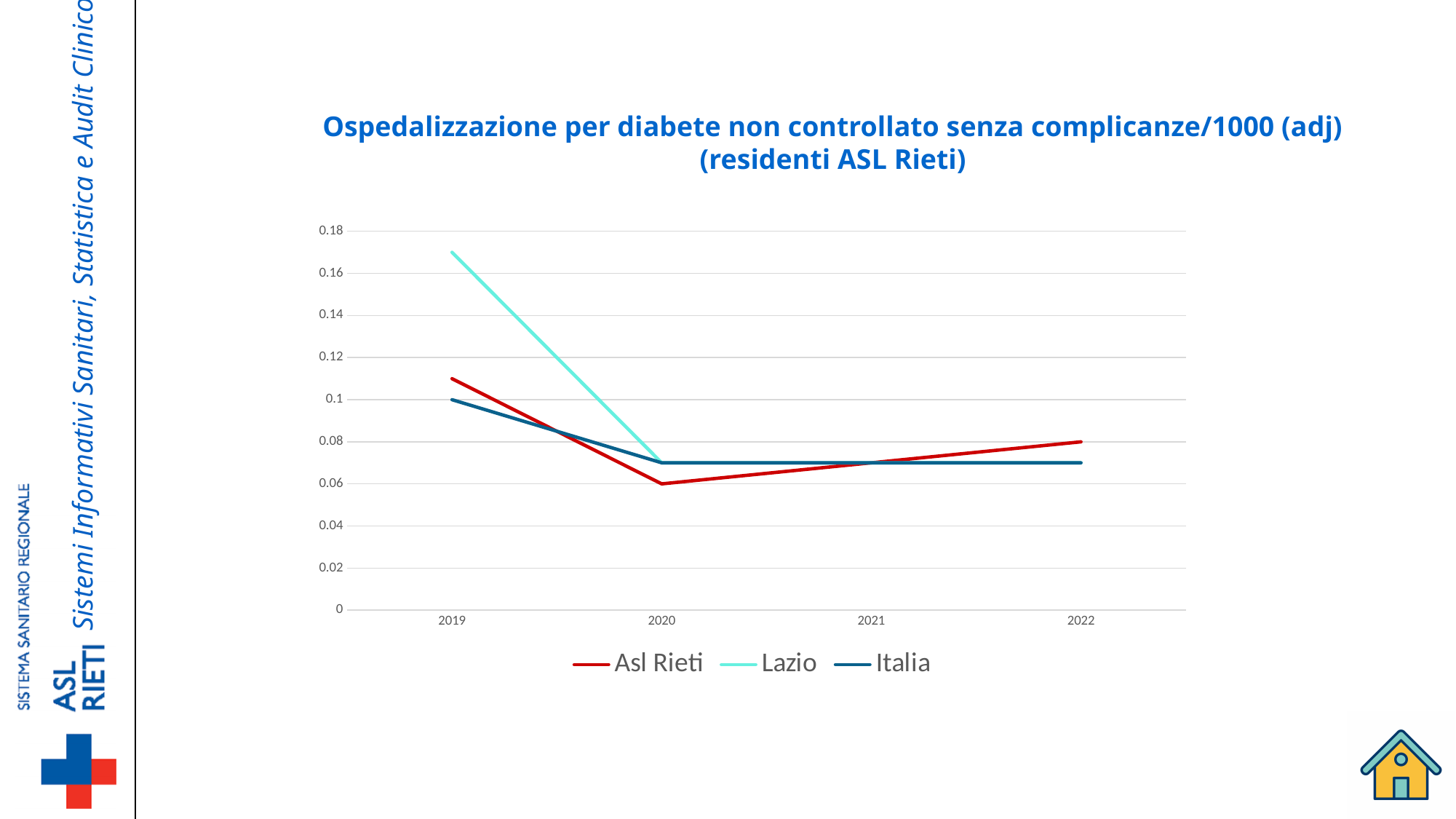
Which series has the lowest value in 2020? Asl Rieti What is the value for Asl Rieti in 2022? 0.08 What is the value for Italia in 2019? 0.1 By how much did the Asl Rieti value increase from 2020 to 2022? 0.02 What kind of chart is shown on the slide? line chart Which series has the highest value in 2019? Lazio In 2022, which is larger: Asl Rieti or Italia? Asl Rieti Is the value for Lazio in 2019 greater or less than 0.16? greater Is the value for Italia in 2022 greater or less than 0.08? less What is the value for Asl Rieti in 2020? 0.06 How many years are shown on the x axis? 4 How many series does the legend list? 3